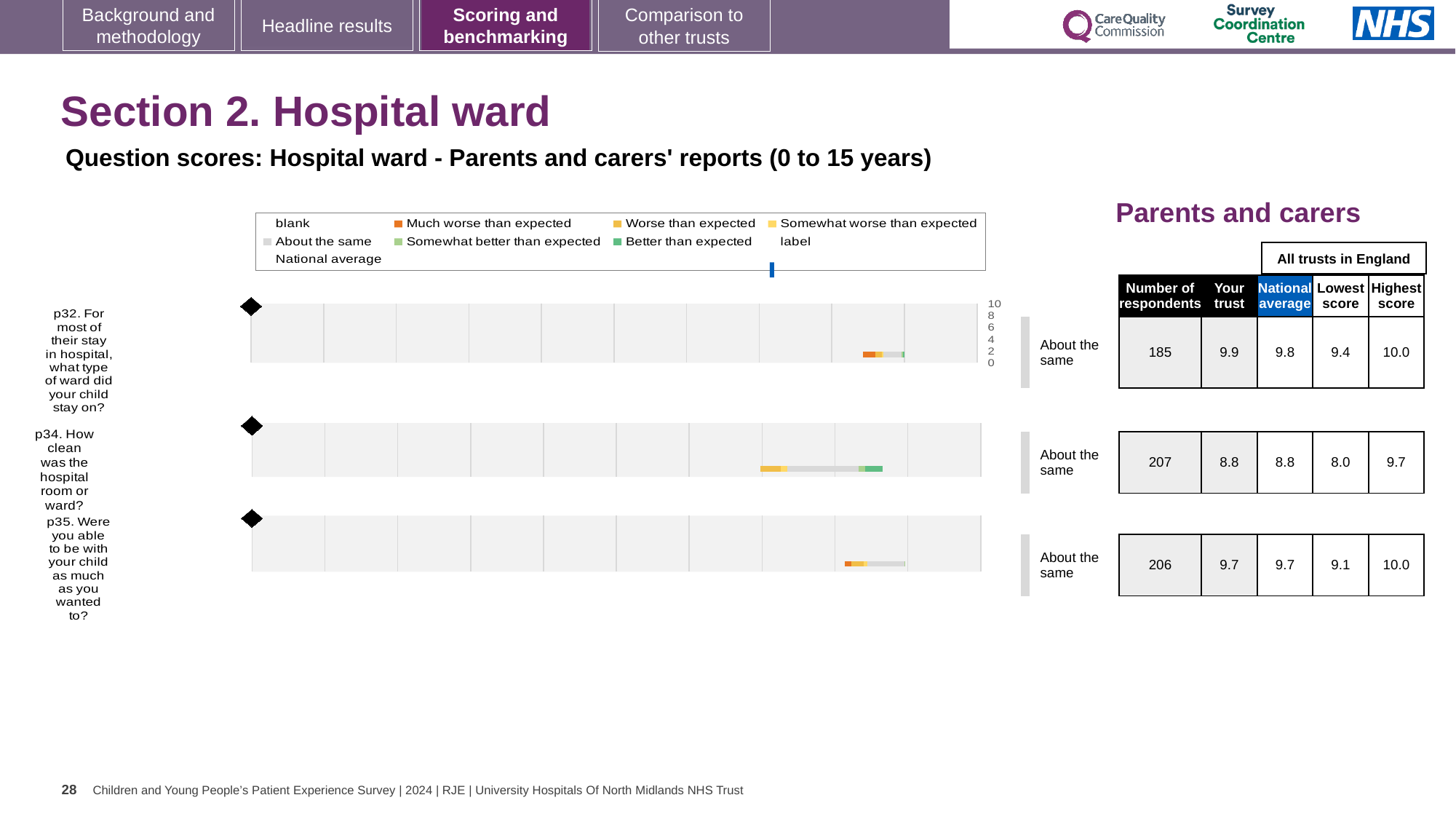
In the table beside the chart, how many respondents answered p32? 185 In the table beside the chart, what is the highest score across all trusts in England for p35? 10.0 How many survey questions (bars) are plotted in the chart? 3 In the table beside the chart, what is the 'Your trust' score for p34 (How clean was the hospital room or ward)? 8.8 Which question has the lowest 'Your trust' score in the table beside the chart? p34 Which legend entry is shown in orange in the chart legend? Much worse than expected What kind of chart is shown on the slide? bar chart In the table beside the chart, what is the lowest score across all trusts in England for p34? 8.0 For p32, is the 'Your trust' score or the national average higher in the table beside the chart? Your trust What is the title of the chart section shown on the slide? Question scores: Hospital ward - Parents and carers' reports (0 to 15 years) Which question has the highest 'Your trust' score in the table beside the chart? p32 What is the difference between the highest score and the lowest score for p34 in the table beside the chart? 1.7